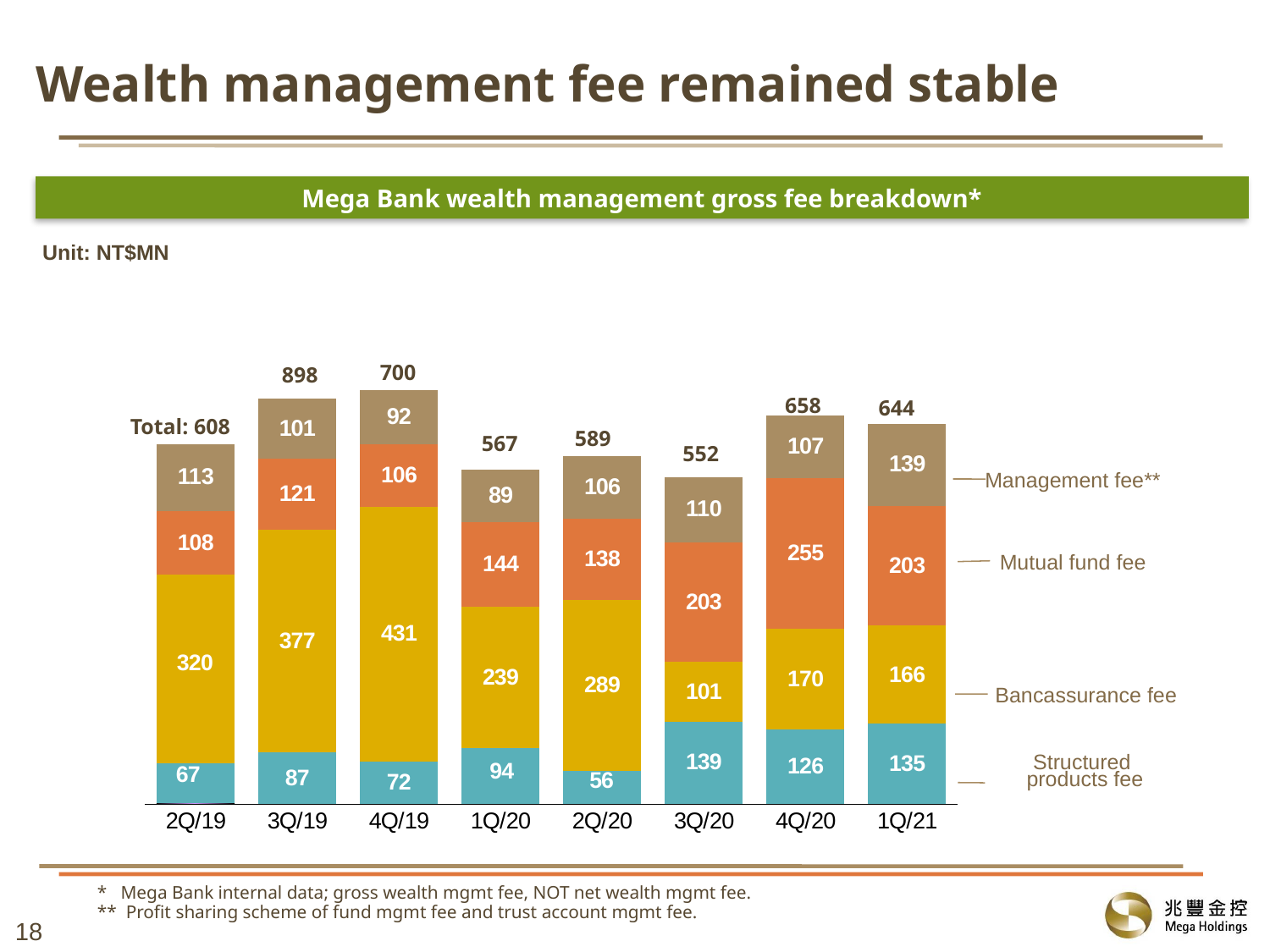
What is the total wealth management gross fee shown for 2Q/19? 608 How many fee categories are stacked in each bar? 4 How many quarters are shown on the x axis? 8 Which quarter has the highest total wealth management gross fee? 3Q/19 What is the Bancassurance fee for 4Q/19? 431 What type of chart is shown on the slide? Stacked bar chart What is the Structured products fee for 2Q/20? 56 Which is larger in 3Q/20: the Structured products fee or the Bancassurance fee? Structured products fee What is the difference between the Mutual fund fee in 4Q/20 and in 1Q/21? 52 What is the Mutual fund fee for 4Q/20? 255 Which quarter has the lowest total wealth management gross fee? 3Q/20 What is the Management fee for 1Q/21? 139